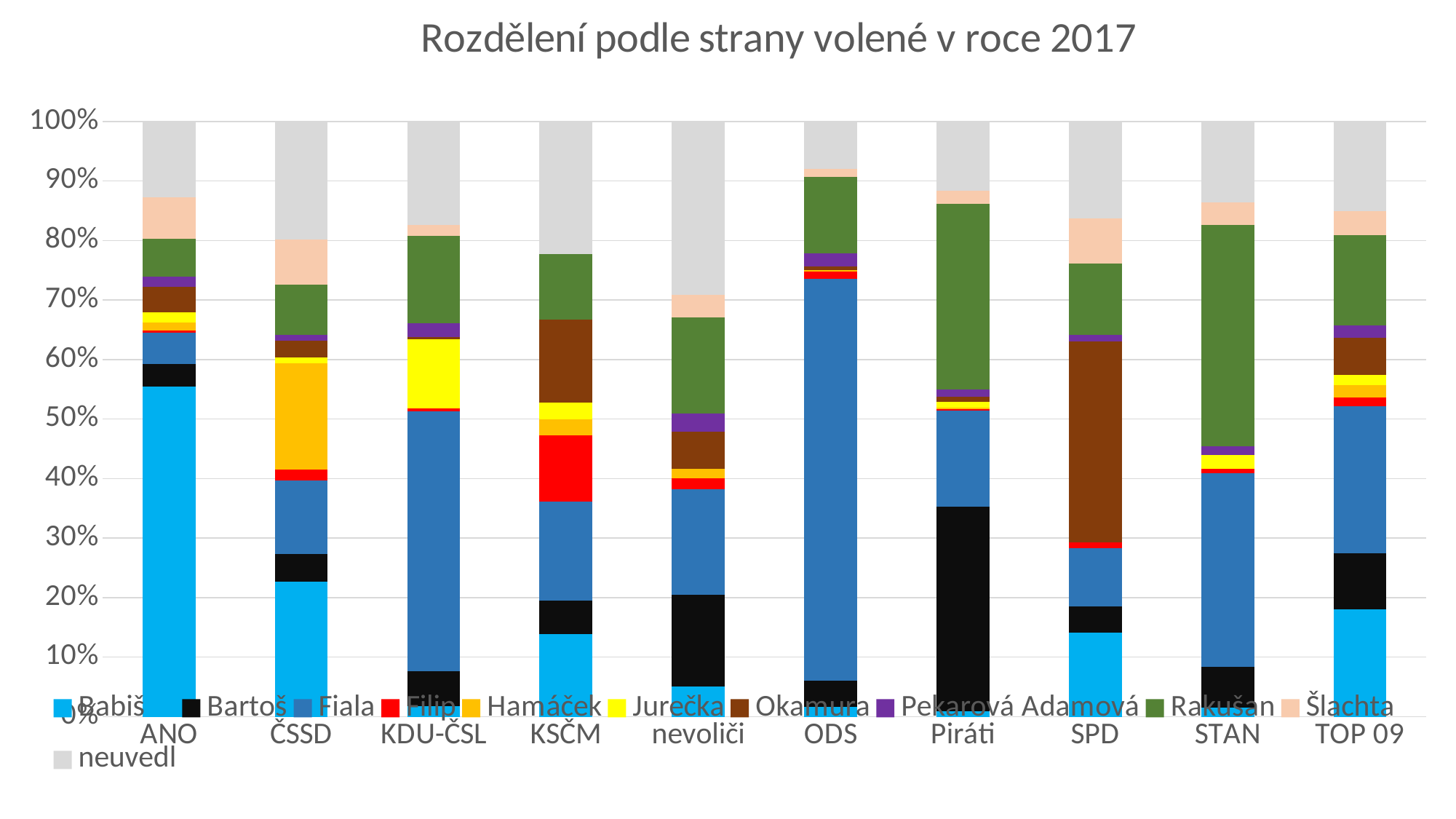
Is the Okamura share for SPD greater or less than 30%? greater How many series does the legend list? 11 Is the Bartoš share for Piráti greater or less than 30%? greater What kind of chart is shown on the slide? stacked bar chart Which category has the largest neuvedl segment? nevoliči Is the Fiala share for ODS greater or less than 60%? greater Is the Babiš segment larger for ANO or for ČSSD? ANO Which party has the largest Rakušan segment? STAN Which party has the largest Babiš segment? ANO What is the title of the chart? Rozdělení podle strany volené v roce 2017 How many party categories are shown on the x axis? 10